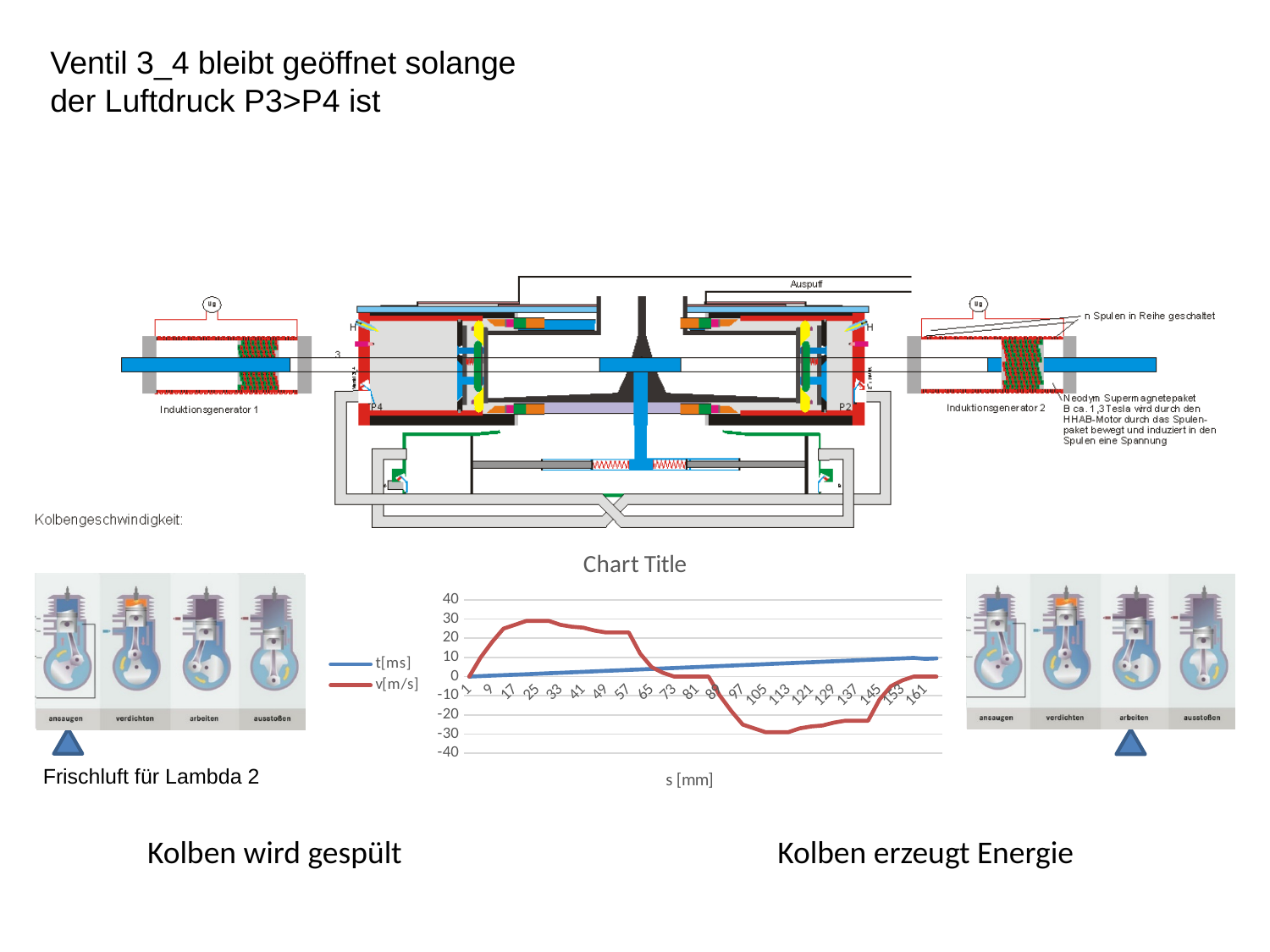
What are the two series named in the chart legend? t[ms] and v[m/s] What kind of chart is shown under the heading "Chart Title"? line chart How many series does the legend of the chart list? 2 How many tick labels are shown on the x axis of the chart? 21 Is the value of v[m/s] at s = 105 greater or less than -20? less Does the t[ms] series rise or fall as s [mm] increases? rise Is the value of v[m/s] at s = 57 greater or less than 10? greater What is the label of the x axis of the chart? s [mm] At s = 105, which series has the larger value, t[ms] or v[m/s]? t[ms] Is the highest value reached by the v[m/s] series greater or less than 20? greater At s = 25, which series has the larger value, t[ms] or v[m/s]? v[m/s]